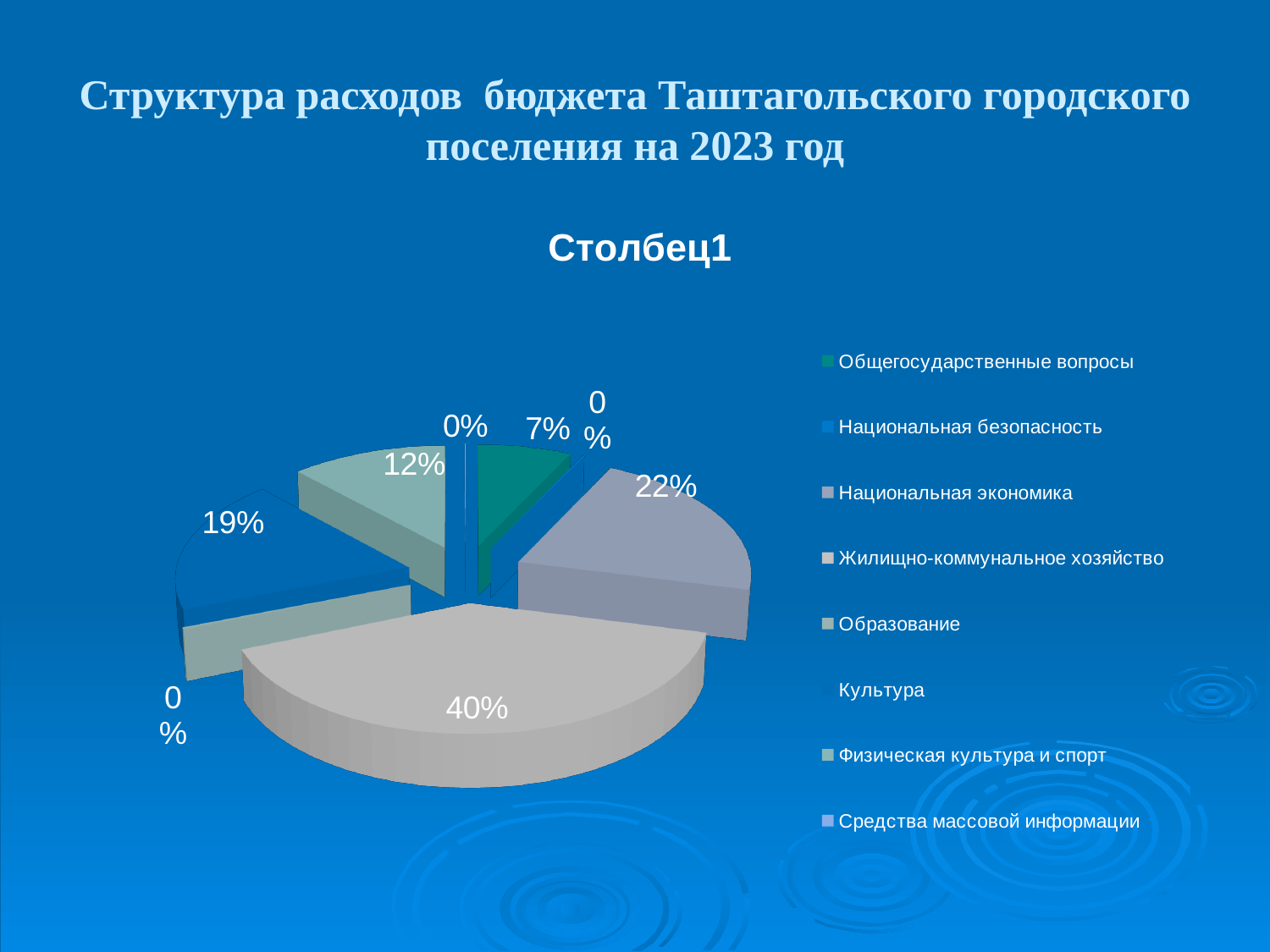
What share of the pie is Физическая культура и спорт? 12% What share of the pie is Культура? 19% What is the title of the chart? Столбец1 What share of the pie is Национальная экономика? 22% What kind of chart is shown on the slide? pie chart How many slices are labelled 0%? 3 How many categories does the legend list? 8 By how many percentage points does the share for Жилищно-коммунальное хозяйство exceed the share for Национальная экономика? 18 Which category has the largest share of the pie? Жилищно-коммунальное хозяйство Which is larger, the share for Национальная экономика or the share for Культура? Национальная экономика